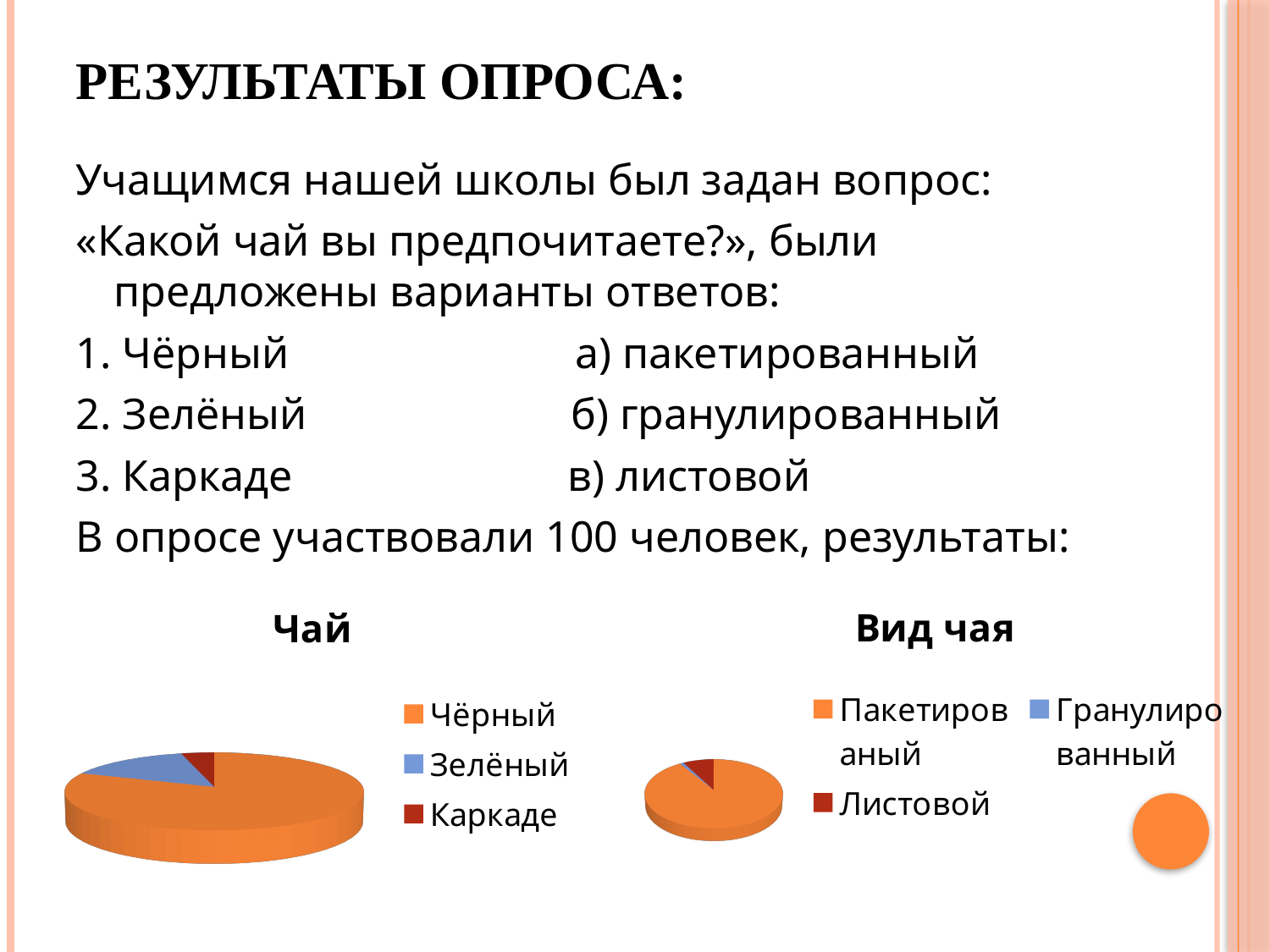
In the "Чай" chart, which slice is larger: Зелёный or Каркаде? Зелёный What kind of chart is the "Чай" chart? pie chart In the "Чай" chart, what colour is the Зелёный slice? blue How many slices does the "Вид чая" pie chart have? 3 In the "Чай" chart, which category has the smallest slice? Каркаде In the "Чай" chart, which category has the largest slice? Чёрный In the "Вид чая" chart, which slice is larger: Пакетированый or Листовой? Пакетированый How many slices does the "Чай" pie chart have? 3 In the "Вид чая" chart, which category has the largest slice? Пакетированый What kind of chart is the "Вид чая" chart? pie chart What is the title of the pie chart on the right side of the slide? Вид чая How many entries does the legend of the "Чай" chart list? 3